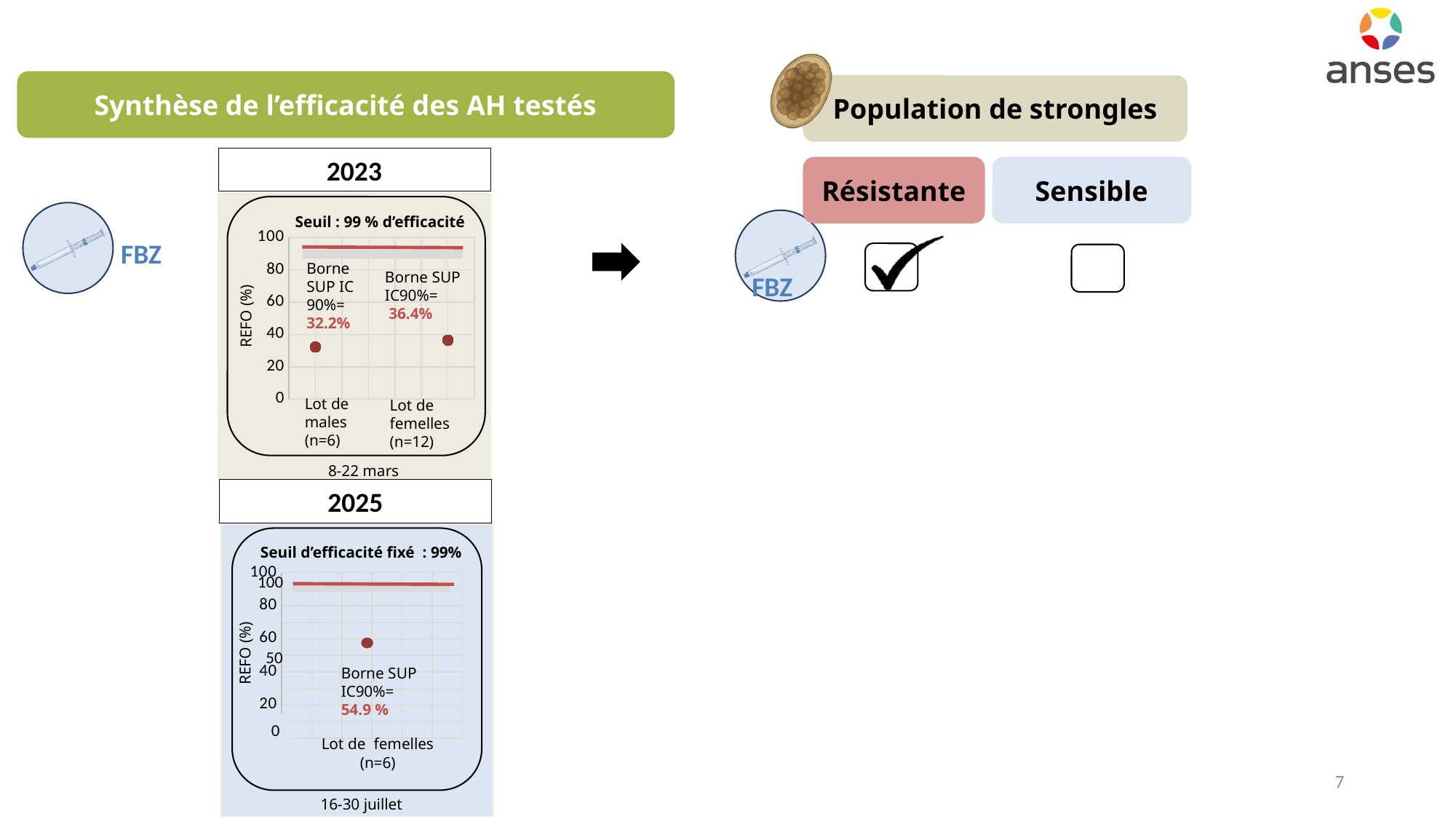
In the 2023 chart, what is the Borne SUP IC90% value for the Lot de femelles (n=12)? 36.4% What efficacy threshold (seuil) is shown in the 2025 chart? 99% In the 2023 chart, is the value for the Lot de males greater or less than 40? less In the 2025 chart, is the value for the Lot de femelles greater or less than 40? greater In the 2023 chart, what is the difference between the Borne SUP IC90% values of the Lot de femelles and the Lot de males? 4.2% In the 2025 chart, what is the Borne SUP IC90% value for the Lot de femelles (n=6)? 54.9 % How many lots are plotted in the 2023 chart? 2 In the 2023 chart, which lot has the lower REFO value? Lot de males (n=6) How many lots are plotted in the 2025 chart? 1 In the 2023 chart, what is the Borne SUP IC90% value for the Lot de males (n=6)? 32.2% In the 2023 chart, which lot has the higher REFO value? Lot de femelles (n=12) What is the y-axis label of the 2023 chart? REFO (%)